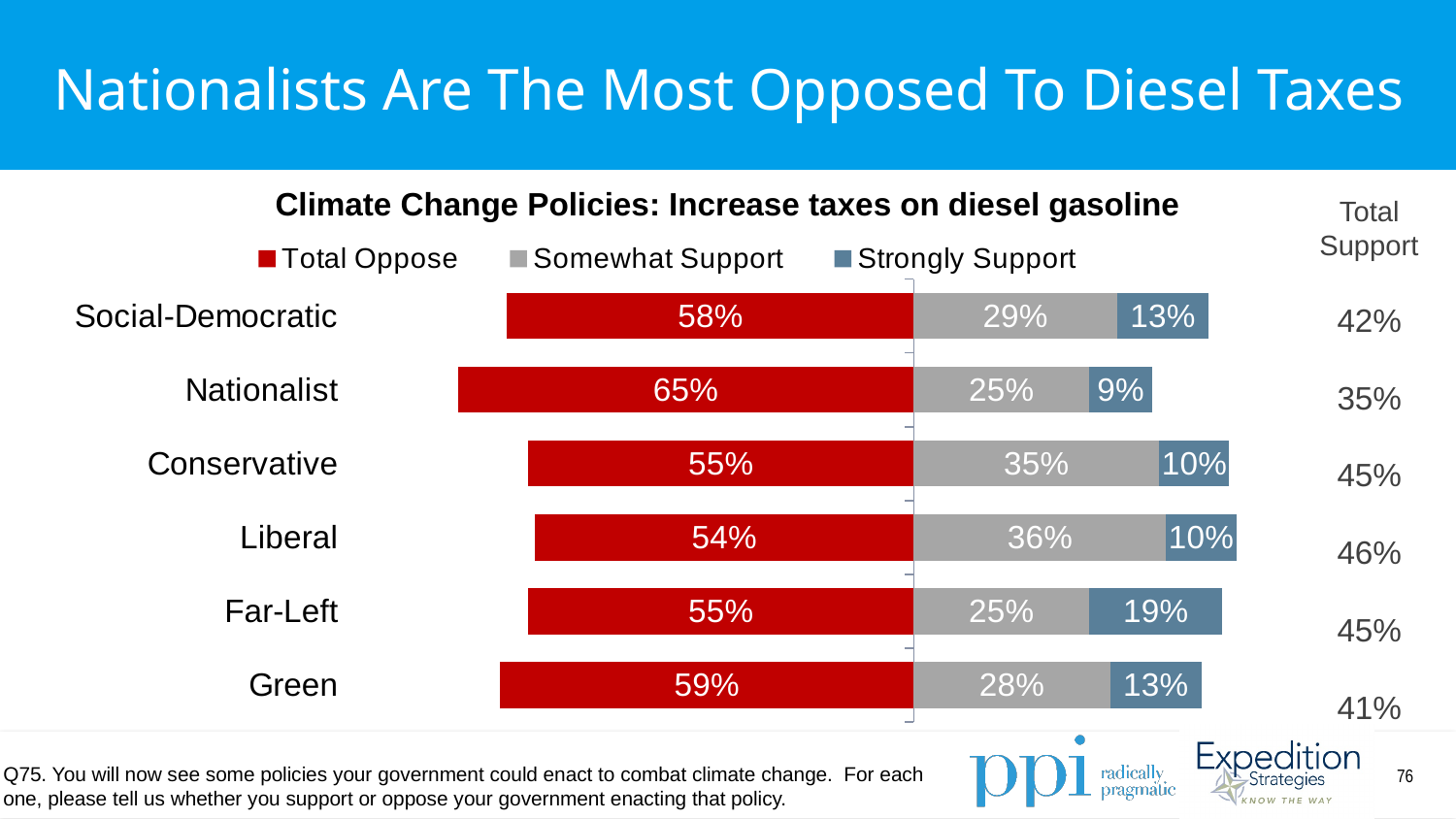
How many parties are shown in the chart? 6 Which party has the lowest Strongly Support value? Nationalist What kind of chart is shown on the slide? Stacked bar chart What is the Total Oppose value for Nationalist? 65% Which party has the highest Total Oppose value? Nationalist What is the Strongly Support value for Far-Left? 19% Which is larger, the Somewhat Support value for Conservative or for Green? Conservative How many series does the legend list? 3 What is the Somewhat Support value for Liberal? 36% What is the difference between the Total Oppose values for Nationalist and Liberal? 11% What is the title of the chart? Climate Change Policies: Increase taxes on diesel gasoline What is the Total Support value shown for Liberal? 46%